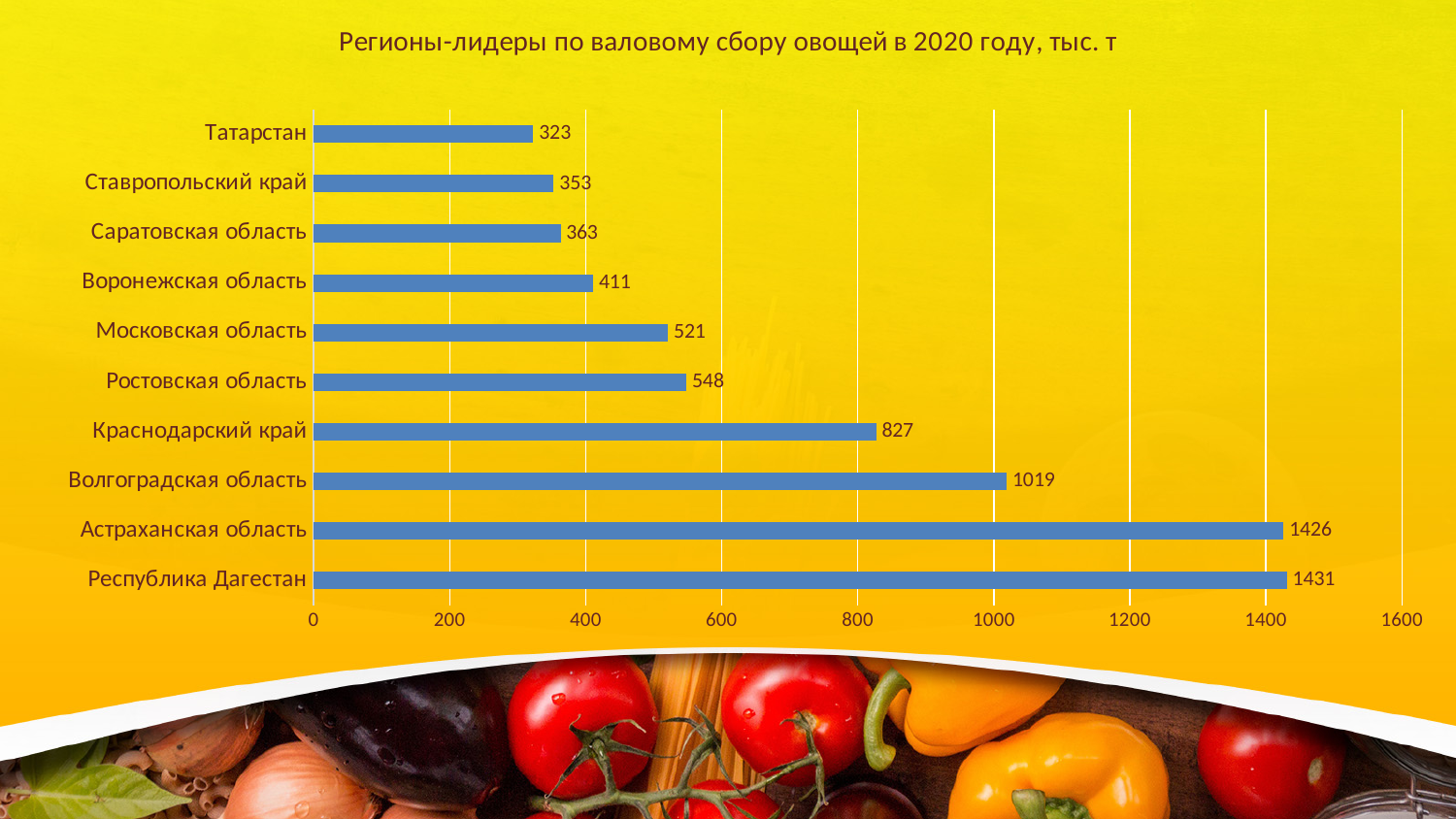
What is the difference between the values for Ростовская область and Московская область? 27 Which region has the lowest value? Татарстан How many regions are shown in the chart? 10 What is the title of the chart? Регионы-лидеры по валовому сбору овощей в 2020 году, тыс. т What is the value for Краснодарский край? 827 Which is larger, the value for Воронежская область or the value for Саратовская область? Воронежская область What kind of chart is shown on the slide? bar chart What is the value for Татарстан? 323 What is the value for Московская область? 521 Is the value for Астраханская область greater or less than 1400? greater Which region has the highest value? Республика Дагестан What is the difference between the values for Волгоградская область and Краснодарский край? 192